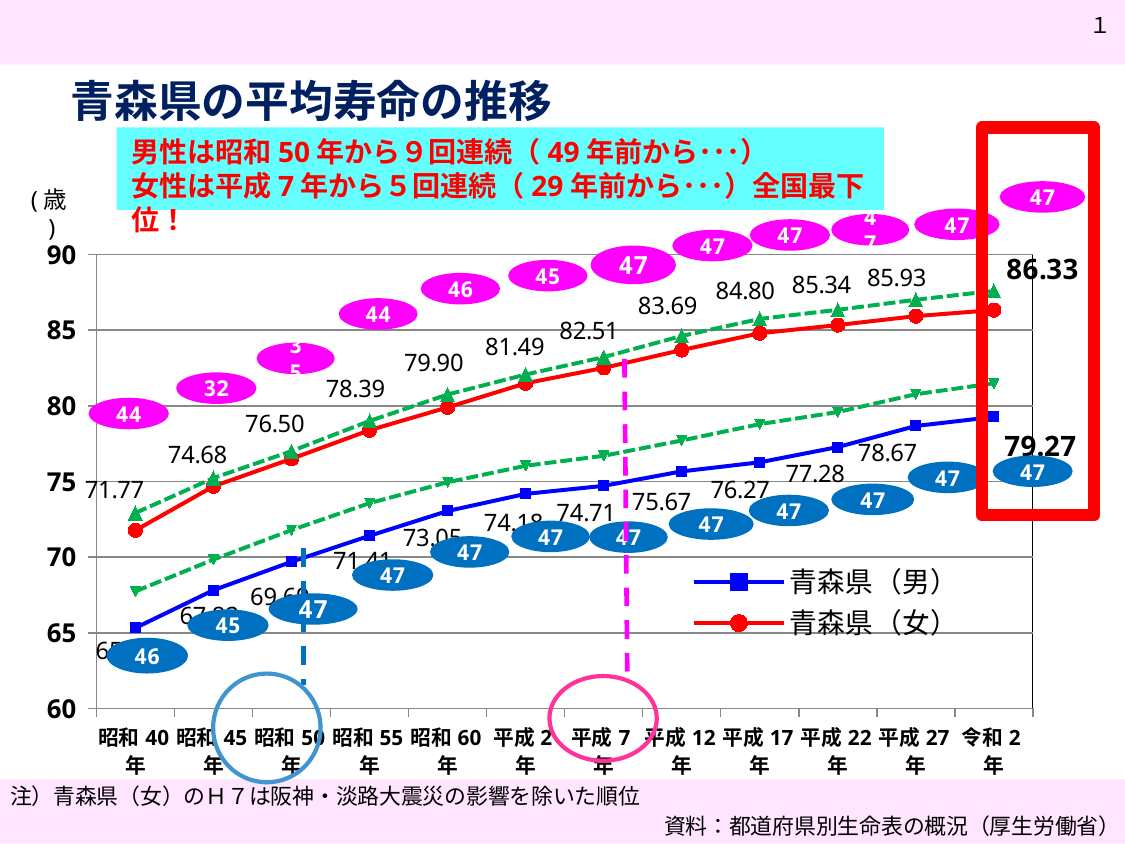
What is the value for 青森県（男） in 令和2年? 79.27 What is the title of the chart? 青森県の平均寿命の推移 What is the value for 青森県（女） in 平成17年? 84.80 How many series does the legend list? 2 Do the values for 青森県（男） rise or fall from 昭和40年 to 令和2年? rise What is the difference between 青森県（女） and 青森県（男） in 令和2年? 7.06 Which series has the higher value in 平成22年, 青森県（男） or 青森県（女）? 青森県（女） What kind of chart is shown on the slide? line chart What is the value for 青森県（男） in 平成7年? 74.71 What is the value for 青森県（女） in 昭和40年? 71.77 How many time points are shown on the x axis? 12 What is the value for 青森県（女） in 令和2年? 86.33